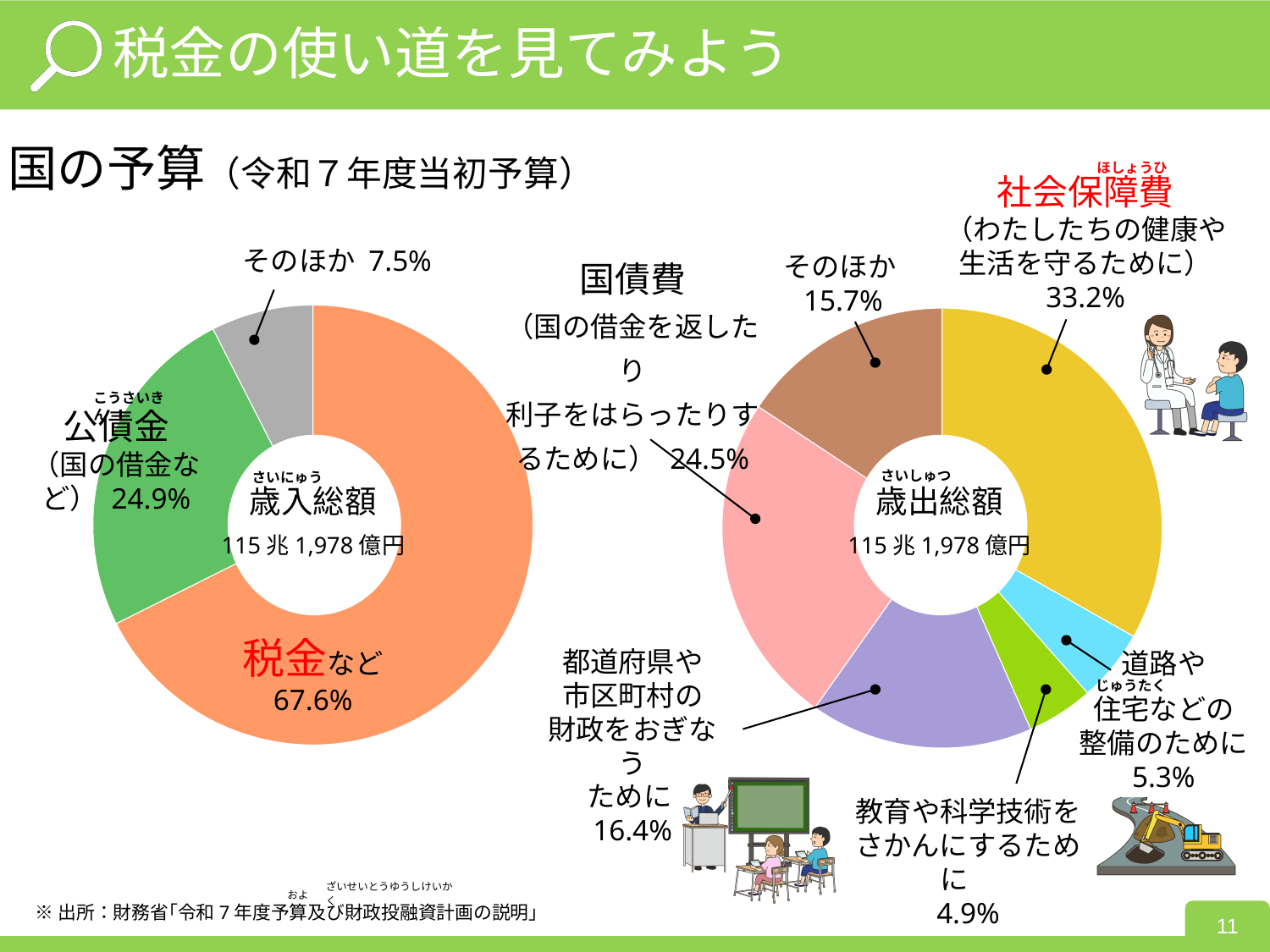
右の「歳出総額」のグラフで、「国債費」と「そのほか」ではどちらの割合が大きいですか？ 国債費 左の「歳入総額」のグラフで、「税金など」と「公債金」の割合の差はいくらですか？ 42.7% 右の「歳出総額」のグラフで、最も割合が小さい項目はどれですか？ 教育や科学技術をさかんにするために 右の「歳出総額」のグラフで、「社会保障費」の割合はいくらですか？ 33.2% 左の「歳入総額」のグラフで、最も割合が小さい項目はどれですか？ そのほか 右の「歳出総額」のグラフには、いくつの項目がありますか？ 6 左の「歳入総額」のグラフで、「公債金」の割合はいくらですか？ 24.9% 左の「歳入総額」のグラフで、最も割合が大きい項目はどれですか？ 税金など 左の「歳入総額」のグラフの中央に書かれている総額はいくらですか？ 115兆1,978億円 このスライドのグラフはどのような種類のグラフですか？ 円グラフ（ドーナツグラフ） 左の「歳入総額」のグラフで、「税金など」の割合はいくらですか？ 67.6% 右の「歳出総額」のグラフで、「国債費」の割合はいくらですか？ 24.5%